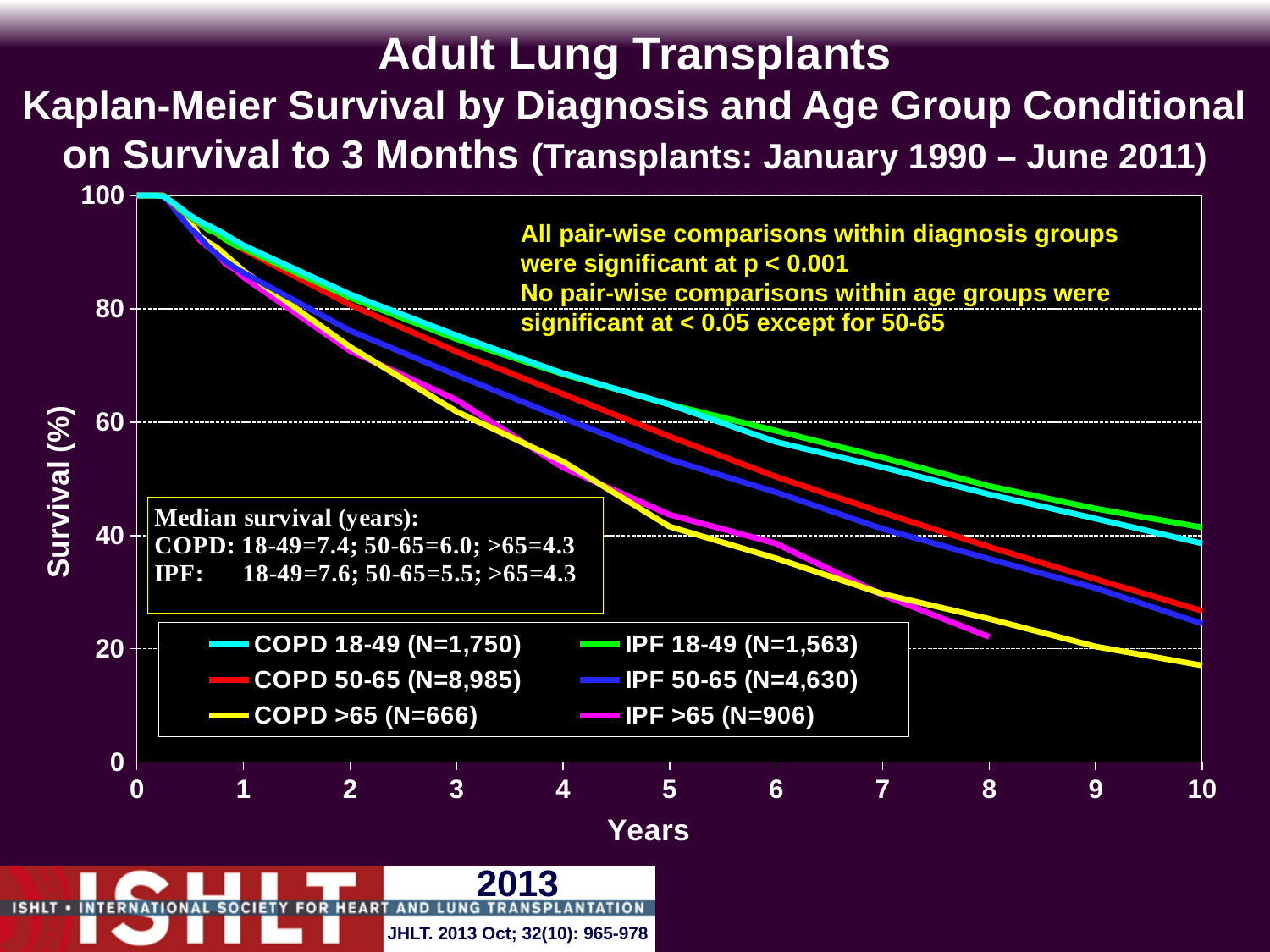
Is the survival value for COPD >65 at 1 year greater or less than 80? greater Which has the larger median survival, COPD 50-65 or IPF 50-65? COPD 50-65 According to the text box, what is the median survival in years for IPF recipients aged 50-65? 5.5 Is the survival value for COPD >65 at 10 years greater or less than 20? less What is the N for the COPD 50-65 group shown in the legend? 8,985 Which diagnosis and age group has the highest median survival listed in the text box? IPF 18-49 What kind of chart is shown on the slide? line chart How many series does the legend list? 6 What colour is the line for COPD >65 (N=666)? yellow What is the difference in median survival between COPD 50-65 and IPF 50-65? 0.5 years Do the survival curves rise or fall as years since transplant increase? fall According to the text box, what is the median survival in years for COPD recipients aged 18-49? 7.4